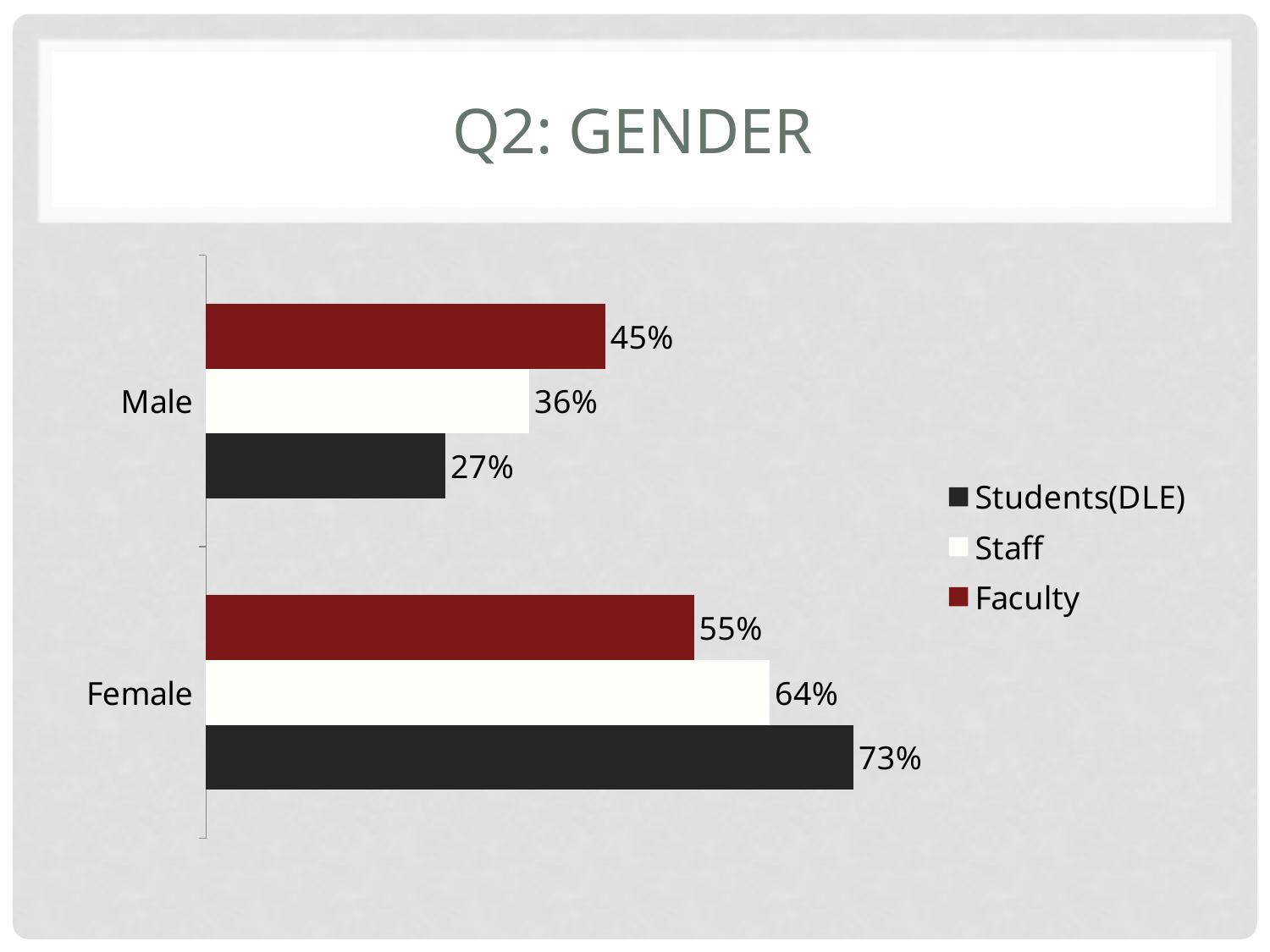
Which is larger: the Male percentage for Faculty or for Staff? Faculty What percentage of Faculty are Female? 55% Which group has the highest Female percentage? Students(DLE) What is the title of the slide? Q2: GENDER What kind of chart is shown on the slide? Bar chart What is the difference between the Staff and Faculty Female percentages? 9% What percentage of Staff are Male? 36% What is the difference between the Female and Male percentages for Students(DLE)? 46% What percentage of Students(DLE) are Female? 73% Which group has the lowest Male percentage? Students(DLE) How many series does the legend list? 3 What percentage of Faculty are Male? 45%